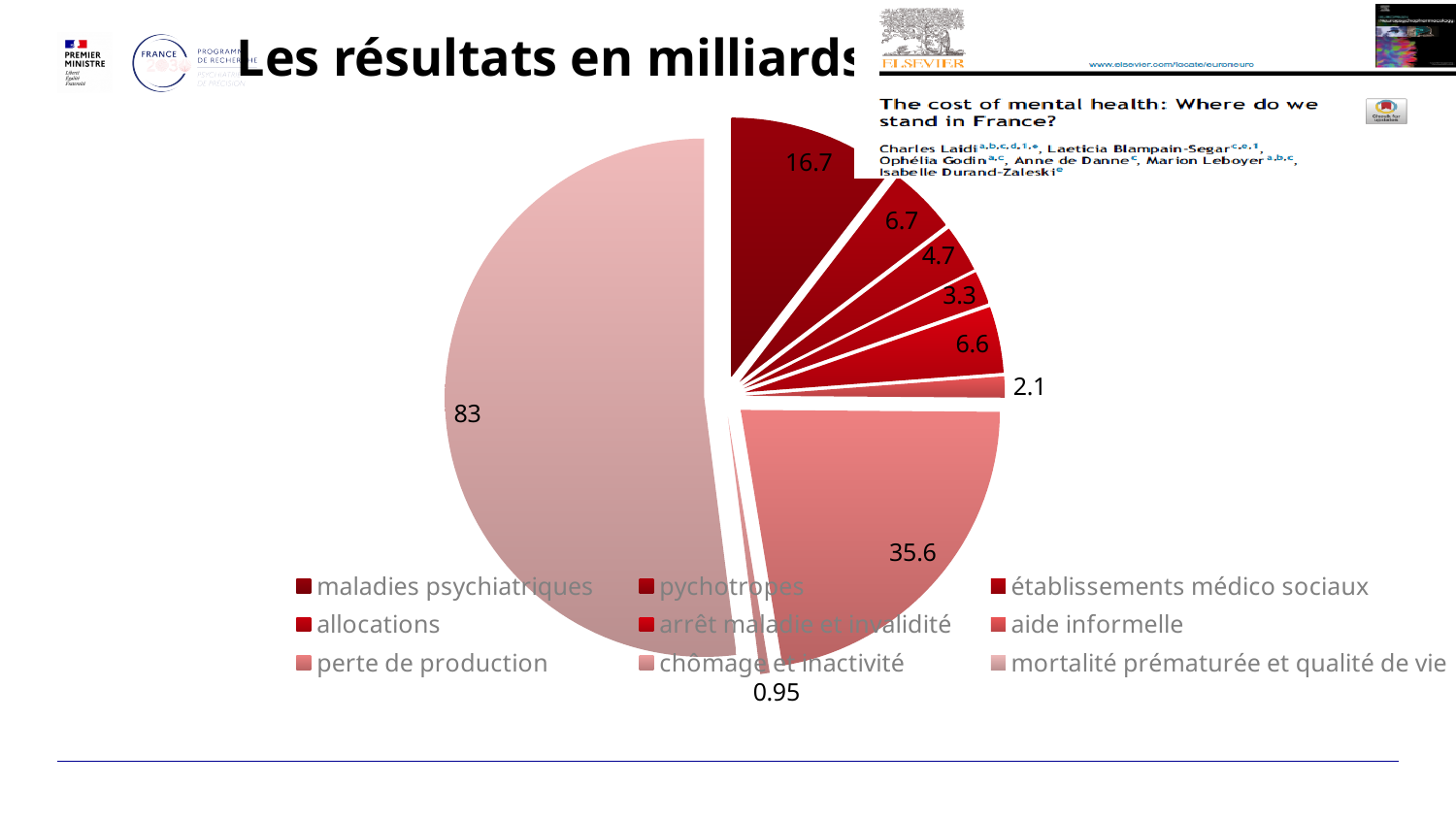
What is the value of the largest slice in the pie chart? 83 What is the value of the slice for 'maladies psychiatriques' in the pie chart? 16.7 What is the difference between the slices labelled 16.7 and 6.6? 10.1 What is the difference between the slice labelled 83 and the slice labelled 35.6? 47.4 How many slices does the pie chart have? 9 What is the value of the slice for 'perte de production' in the pie chart? 35.6 What kind of chart is shown on the slide? pie chart Which is larger in the pie chart: the slice labelled 6.7 or the slice labelled 4.7? 6.7 How many entries does the legend of the pie chart list? 9 What is the title of the slide containing the pie chart? Les résultats en milliards What is the value of the smallest slice in the pie chart? 0.95 Which legend category corresponds to the largest slice (83) in the pie chart? mortalité prématurée et qualité de vie